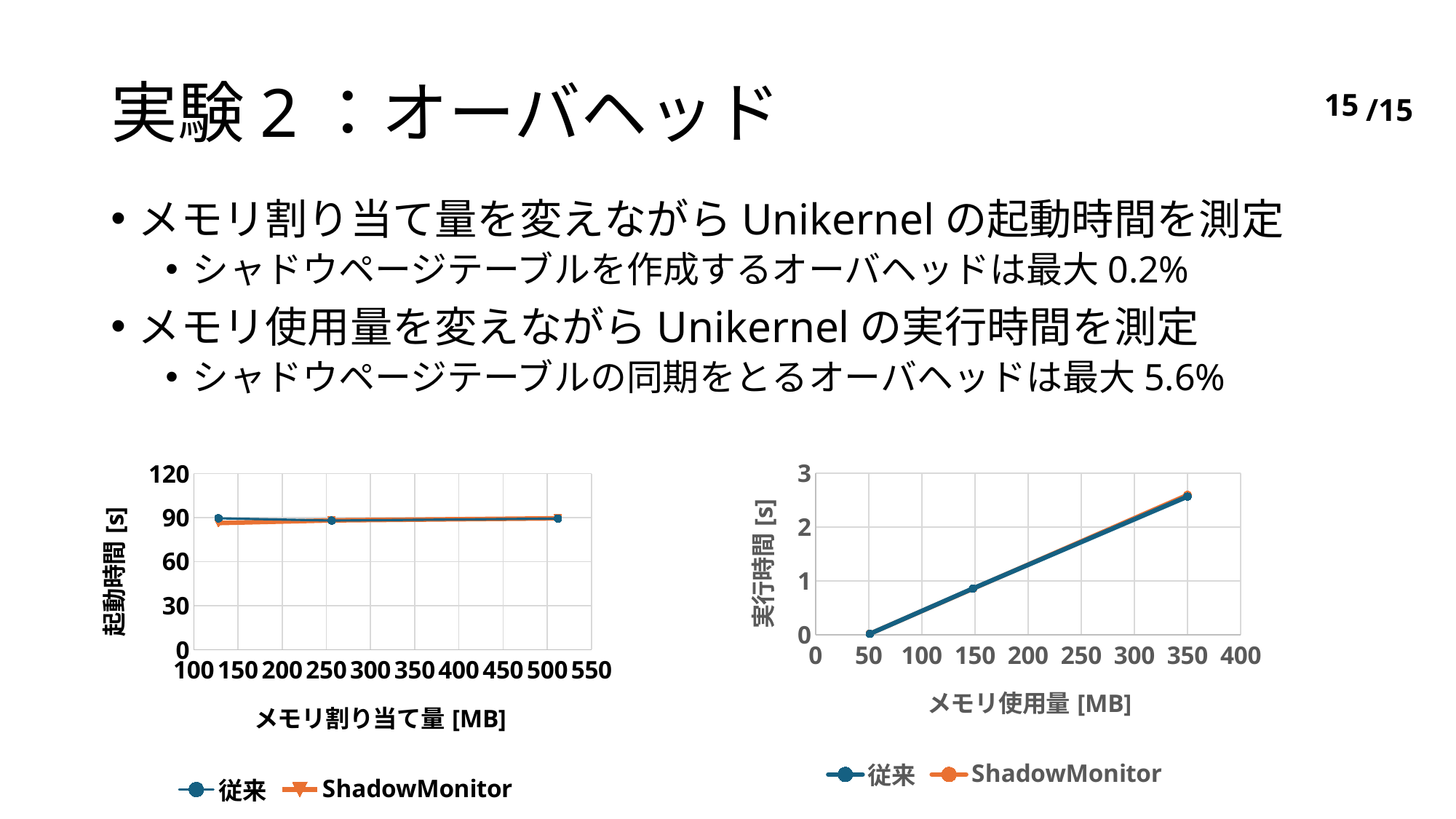
In the right chart, is the 実行時間 value for ShadowMonitor at 150 MB greater or less than 1? less In the right chart, do the 実行時間 values rise or fall as メモリ使用量 increases? rise What is the x-axis label of the right chart? メモリ使用量 [MB] In the right chart, is the 実行時間 value for 従来 at 350 MB greater or less than 2? greater In the left chart, how many data points are plotted for the ShadowMonitor series? 3 How many series does the legend of the left chart list? 2 What is the y-axis label of the left chart? 起動時間 [s] What kind of chart is the right chart (実行時間 [s] vs メモリ使用量 [MB])? line chart How many series does the legend of the right chart list? 2 In the left chart, is the 起動時間 value for 従来 at about 256 MB greater or less than 60? greater In the right chart, how many data points are plotted for the 従来 series? 3 What kind of chart is the left chart (起動時間 [s] vs メモリ割り当て量 [MB])? line chart